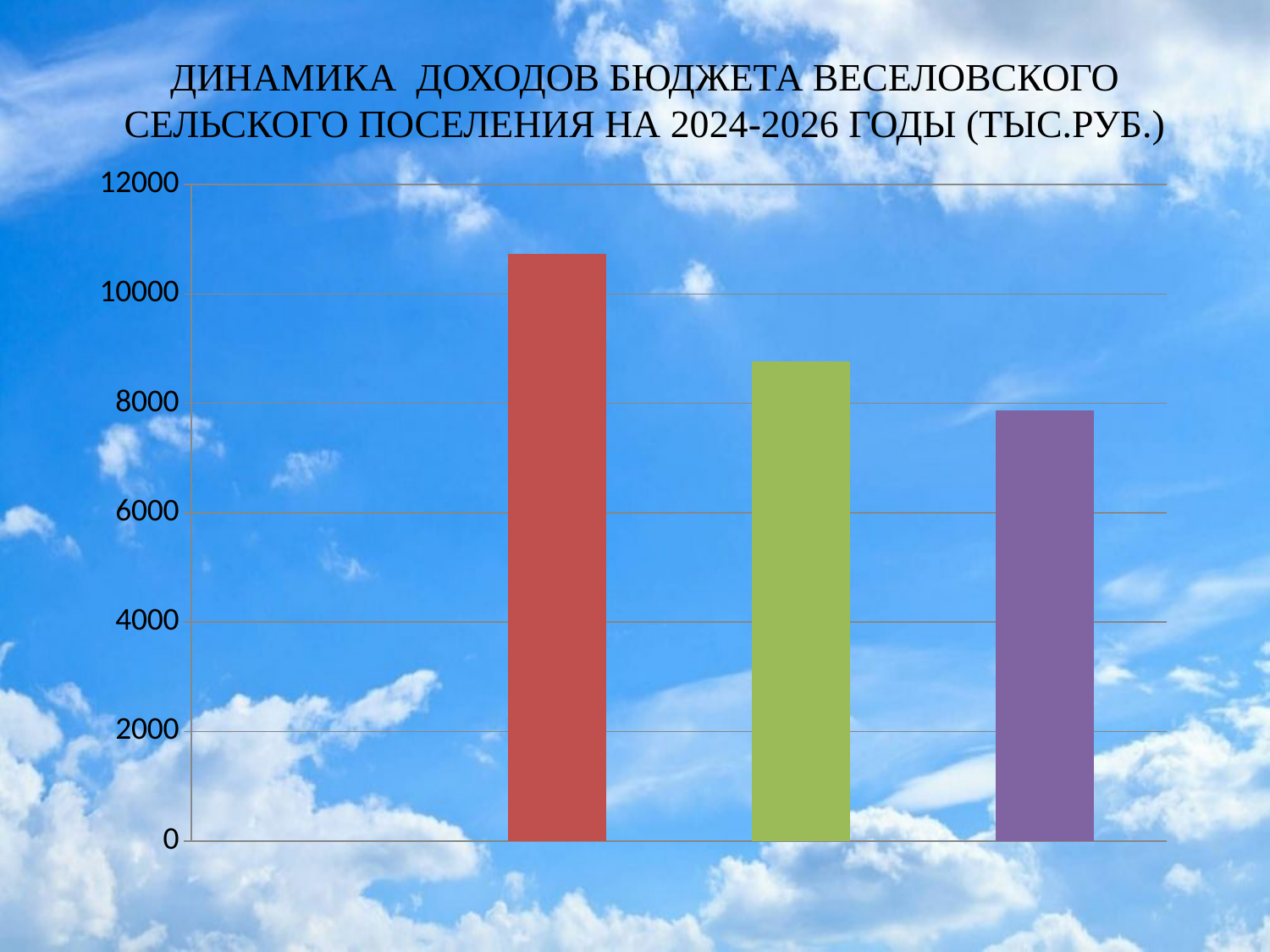
Which is larger, the red bar or the green bar? red bar What kind of chart is shown on the slide? bar chart Is the value of the green (second) bar greater or less than 8000? greater Which bar is the shortest in the chart: the red, green or purple one? purple According to the chart title, which years does the chart cover? 2024-2026 Which bar is the tallest in the chart: the red, green or purple one? red Is the value of the green (second) bar greater or less than 10000? less Is the value of the purple (third) bar greater or less than 6000? greater What is the highest value shown on the vertical axis of the chart? 12000 How many bars are plotted in the chart? 3 Do the bar values rise or fall from left to right across the chart? fall